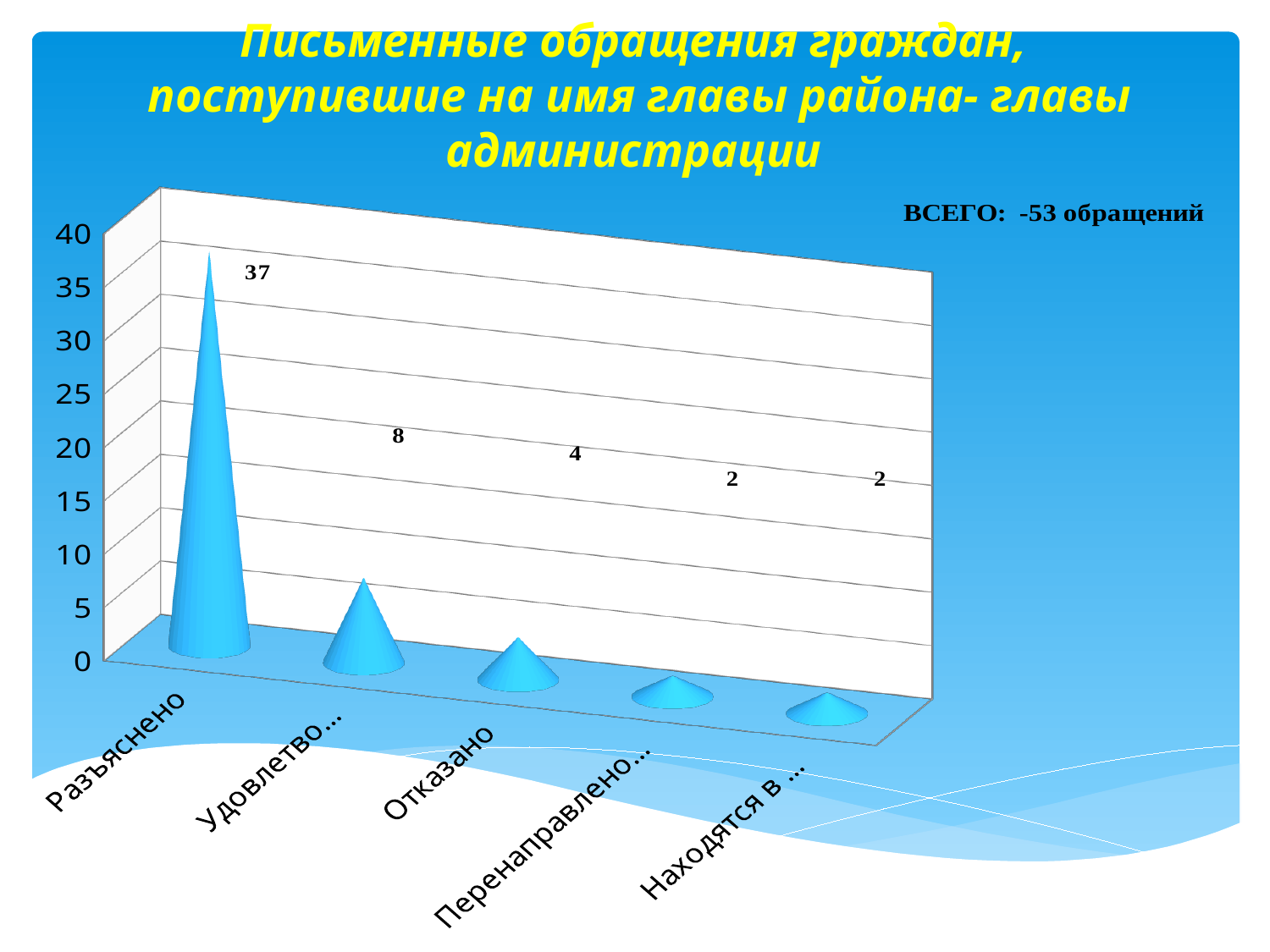
Which is larger, the value for Разъяснено or the value for Отказано? Разъяснено Is the value for Разъяснено greater or less than 30? greater Do the values rise or fall from left to right along the x axis? fall What total number of appeals (ВСЕГО) is stated on the slide? 53 обращений What kind of chart is shown on the slide? bar chart What is the difference between the values for Разъяснено and Отказано? 33 Which category has the highest value? Разъяснено What is the value for Отказано? 4 What is the value for the second category from the left (label beginning "Удовлетво")? 8 What is the value for Разъяснено? 37 How many categories are shown on the x axis? 5 What is the value for the rightmost category (label beginning "Находятся в")? 2